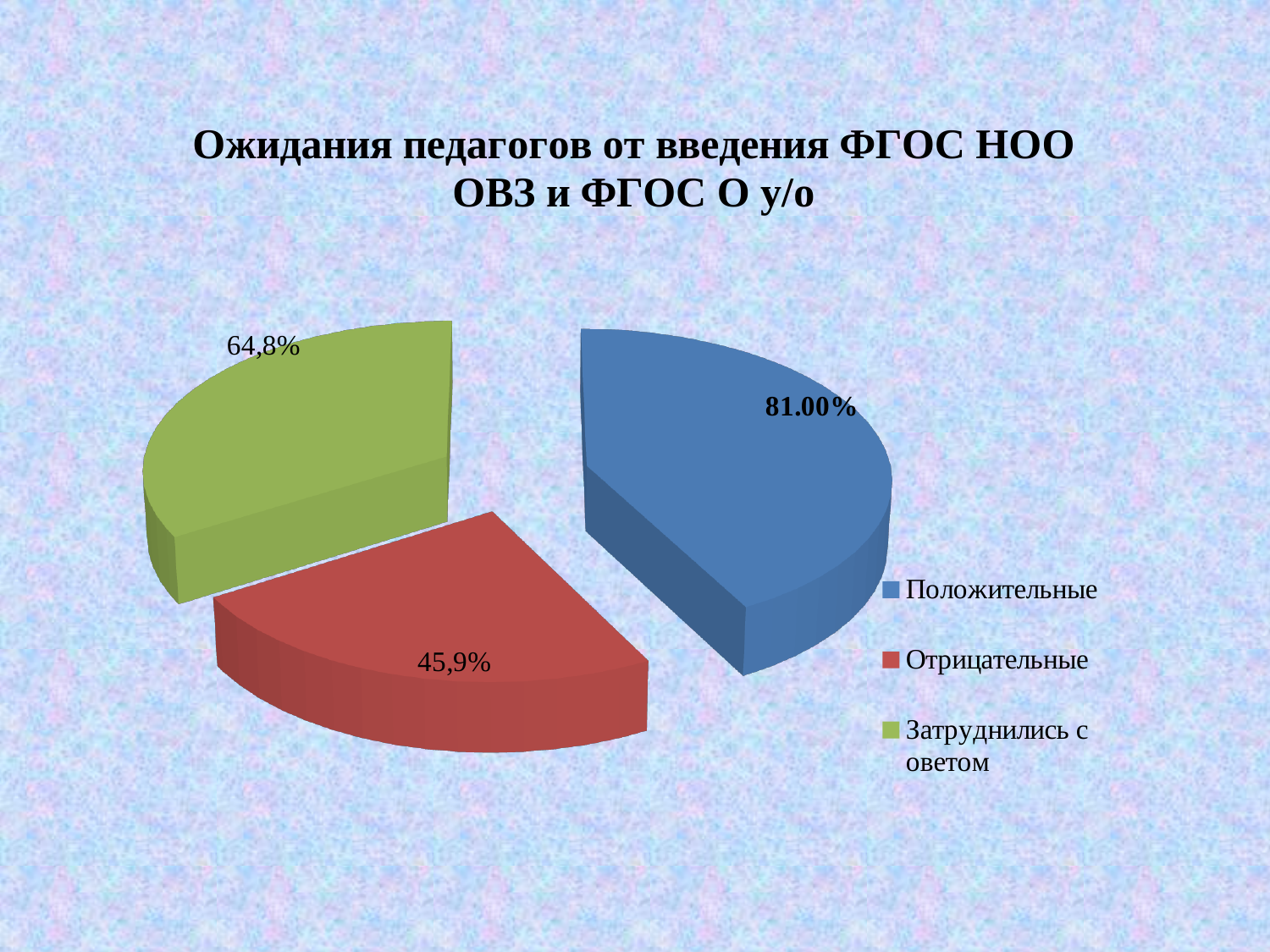
Which has the larger labelled value: Отрицательные or Затруднились с оветом? Затруднились с оветом Which category has the highest labelled value in the pie chart? Положительные What value is shown for the Отрицательные slice? 45,9% What colour is the Отрицательные slice? red How many entries does the legend list? 3 Which category has the lowest labelled value in the pie chart? Отрицательные What is the title of the chart? Ожидания педагогов от введения ФГОС НОО ОВЗ и ФГОС О у/о What is the difference between the labelled values for Затруднились с оветом and Отрицательные? 18,9% How many slices does the pie chart have? 3 What value is shown for the Положительные slice? 81.00% What kind of chart is shown on the slide? pie chart What value is shown for the Затруднились с оветом slice? 64,8%